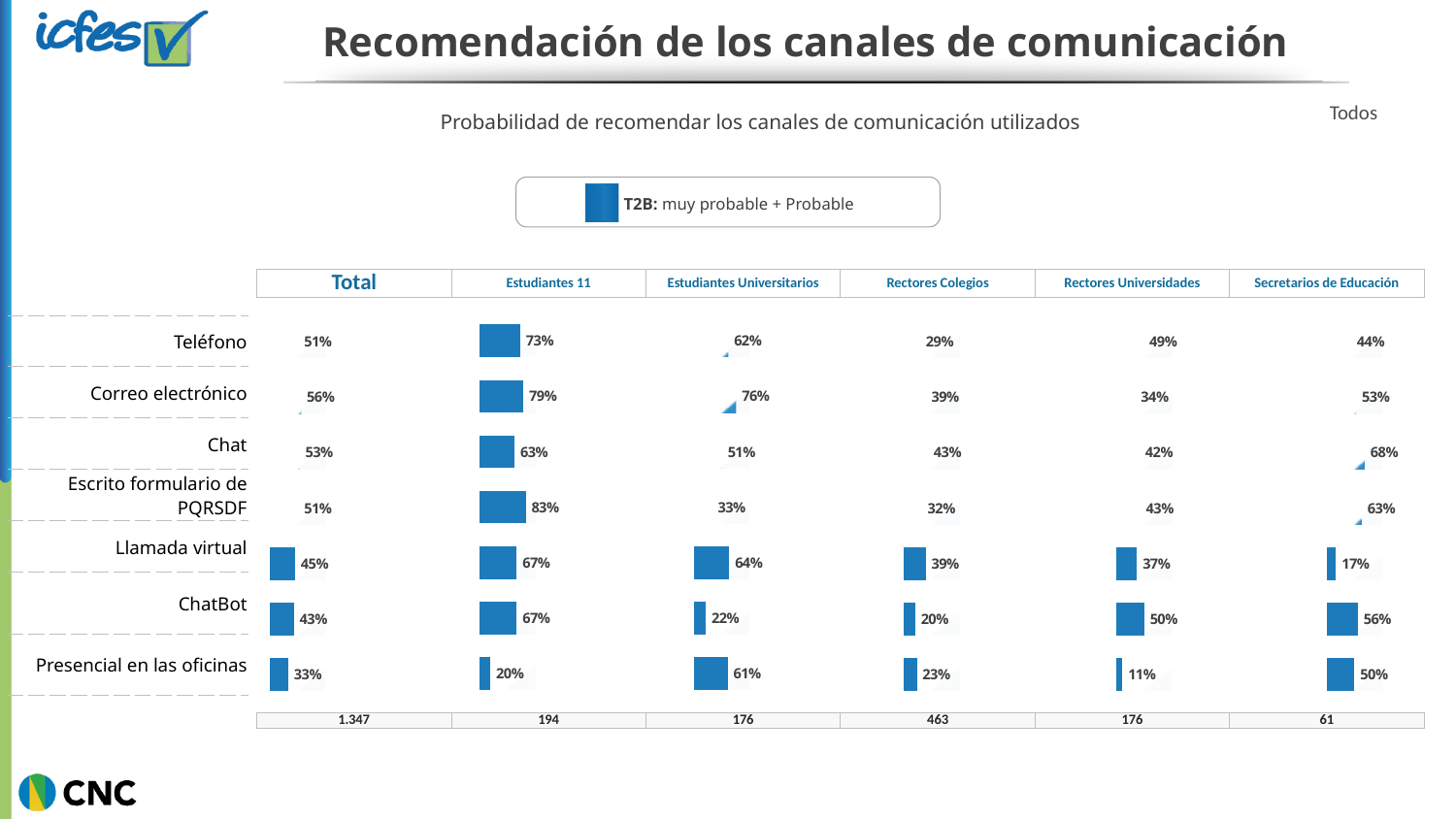
What is the Total value for Correo electrónico? 56% What is the base size shown for the Rectores Colegios column? 463 Which communication channel has the highest value in the Secretarios de Educación column? Chat How many communication channels are listed in the chart? 7 Which communication channel has the lowest value in the Total column? Presencial en las oficinas What is the value for Presencial en las oficinas among Rectores Universidades? 11% Which is larger for Llamada virtual: the Estudiantes Universitarios value or the Rectores Universidades value? Estudiantes Universitarios What does T2B stand for according to the legend box? muy probable + Probable What is the difference between the Estudiantes 11 and Rectores Colegios values for Teléfono? 44% How many respondent groups (columns) does the chart show? 6 What is the value for Escrito formulario de PQRSDF among Estudiantes 11? 83% Which communication channel has the lowest value among Estudiantes Universitarios? ChatBot